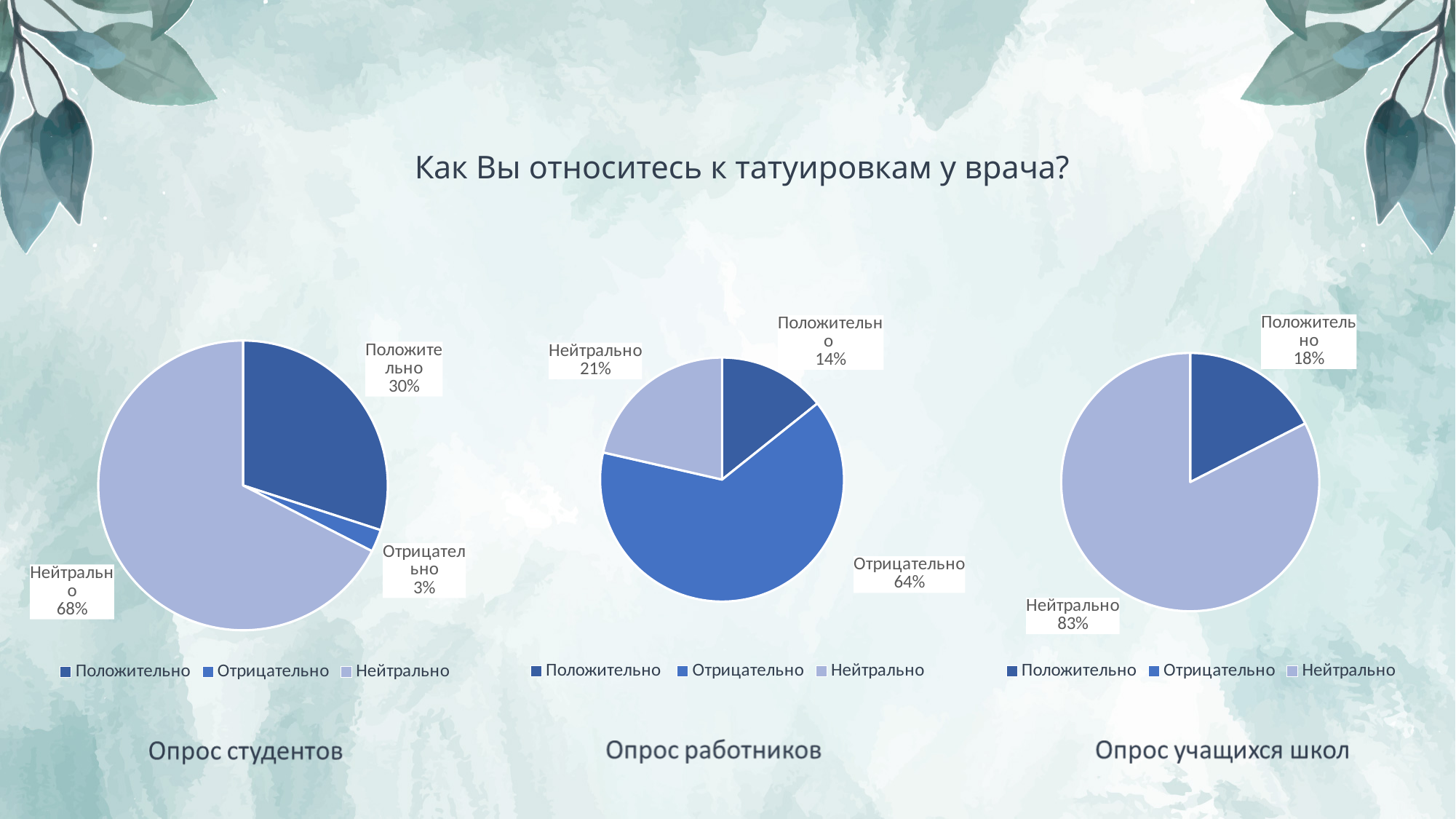
In the "Опрос учащихся школ" chart, what share is labelled for Положительно? 18% In the "Опрос учащихся школ" chart, what share is labelled for Нейтрально? 83% In the "Опрос работников" chart, what share is labelled for Отрицательно? 64% In the "Опрос студентов" chart, which category has the smallest slice? Отрицательно In the "Опрос студентов" chart, what share is labelled for Нейтрально? 68% In the "Опрос работников" chart, what share is labelled for Положительно? 14% In the "Опрос студентов" chart, what share is labelled for Отрицательно? 3% What kind of chart is the "Опрос учащихся школ" chart? Pie chart In the "Опрос студентов" chart, what is the difference between the Нейтрально and Положительно shares? 38% How many entries does the legend of the "Опрос студентов" chart list? 3 In the "Опрос работников" chart, which category has the largest slice? Отрицательно In the "Опрос работников" chart, which is larger: Нейтрально or Положительно? Нейтрально